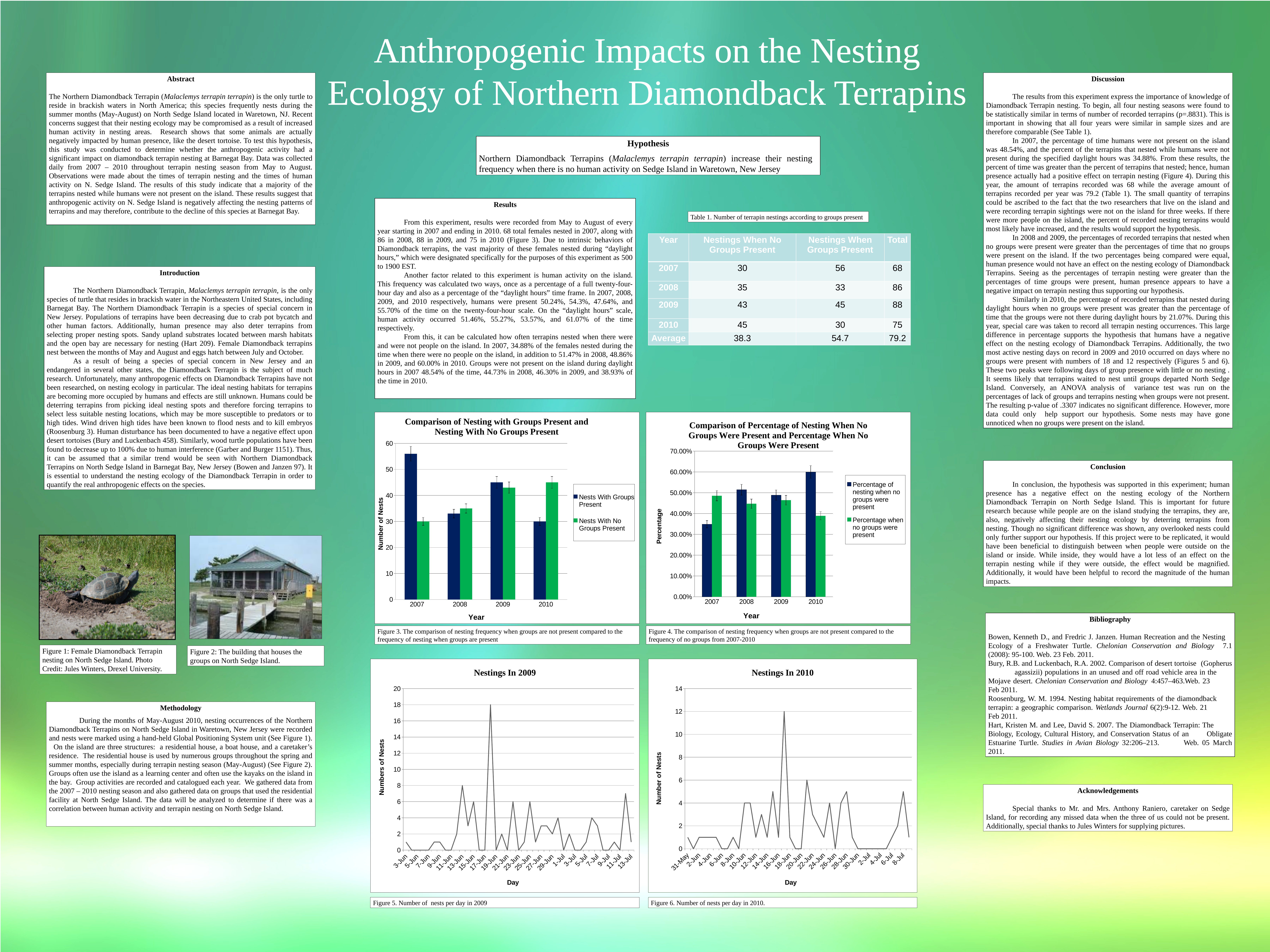
In the 'Nestings In 2010' chart, on which day is the number of nests highest? 17-Jun In the 'Comparison of Percentage of Nesting When No Groups Were Present and Percentage When No Groups Were Present' chart, is the value for Percentage of nesting when no groups were present in 2007 greater or less than 40.00%? less In the 'Nestings In 2009' chart, on which day is the number of nests highest? 18-Jun In the 'Comparison of Nesting with Groups Present and Nesting With No Groups Present' chart, which year has the highest value for Nests With Groups Present? 2007 In the 'Comparison of Nesting with Groups Present and Nesting With No Groups Present' chart, is the value for Nests With Groups Present in 2007 greater or less than 50? greater In the 'Comparison of Nesting with Groups Present and Nesting With No Groups Present' chart, which is larger in 2010: Nests With Groups Present or Nests With No Groups Present? Nests With No Groups Present In the 'Comparison of Nesting with Groups Present and Nesting With No Groups Present' chart, how many years are shown on the x axis? 4 How many series does the legend list in the 'Comparison of Nesting with Groups Present and Nesting With No Groups Present' chart? 2 What kind of chart is 'Comparison of Nesting with Groups Present and Nesting With No Groups Present'? bar chart What kind of chart is 'Nestings In 2010'? line chart In the 'Comparison of Percentage of Nesting When No Groups Were Present and Percentage When No Groups Were Present' chart, which is larger in 2007: Percentage of nesting when no groups were present or Percentage when no groups were present? Percentage when no groups were present